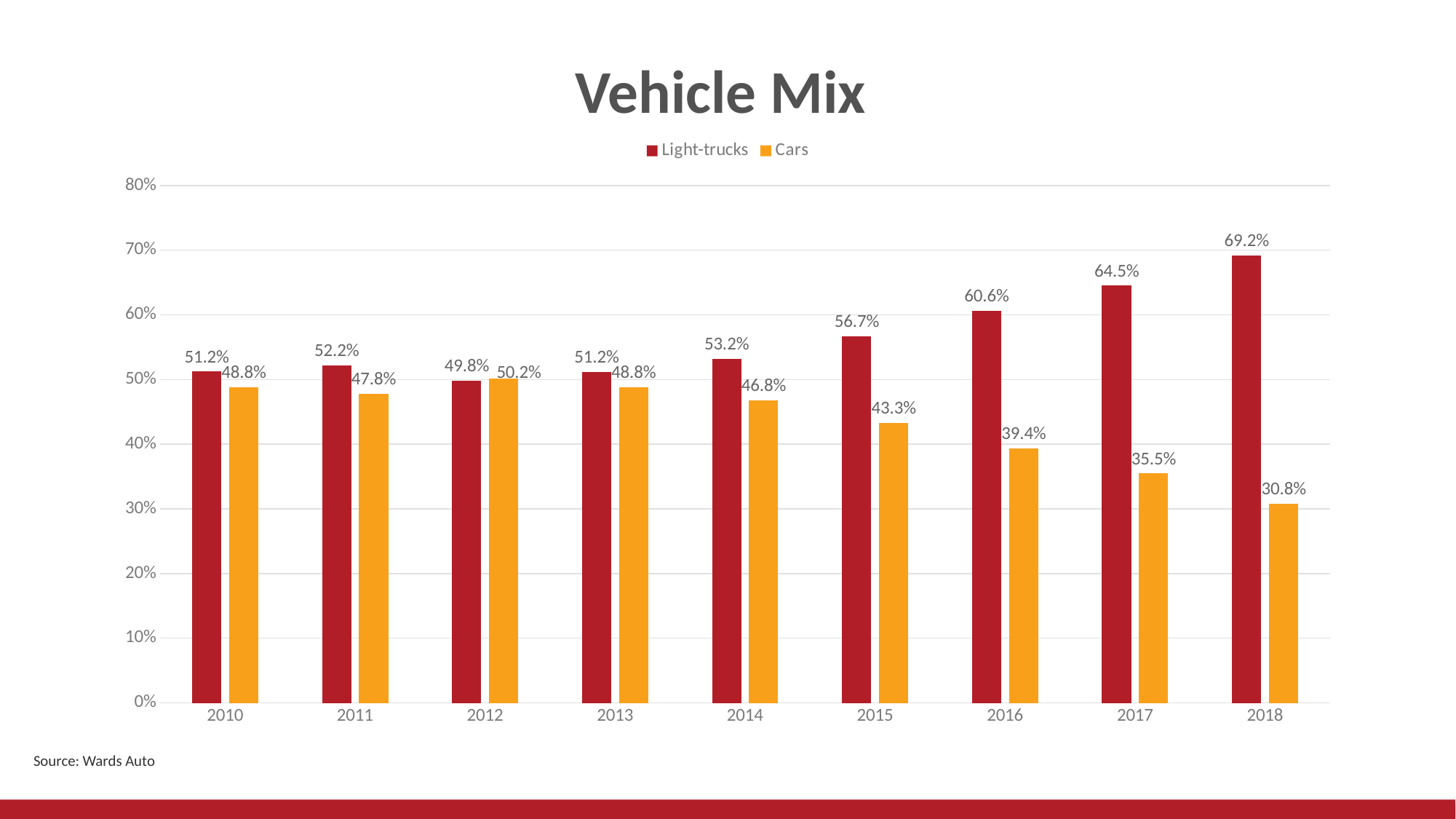
Which year has the highest Light-trucks share? 2018 What is the title of the chart? Vehicle Mix In 2012, which is larger, the Light-trucks share or the Cars share? Cars Does the Cars share rise or fall from 2014 to 2018? Fall What is the Cars share in 2015? 43.3% How many series does the legend list? 2 What is the difference between the Light-trucks and Cars shares in 2017? 29.0% What kind of chart is shown on the slide? Bar chart What is the Light-trucks share in 2018? 69.2% Which year has the lowest Cars share? 2018 What is the Cars share in 2012? 50.2% How many years are shown on the x axis? 9